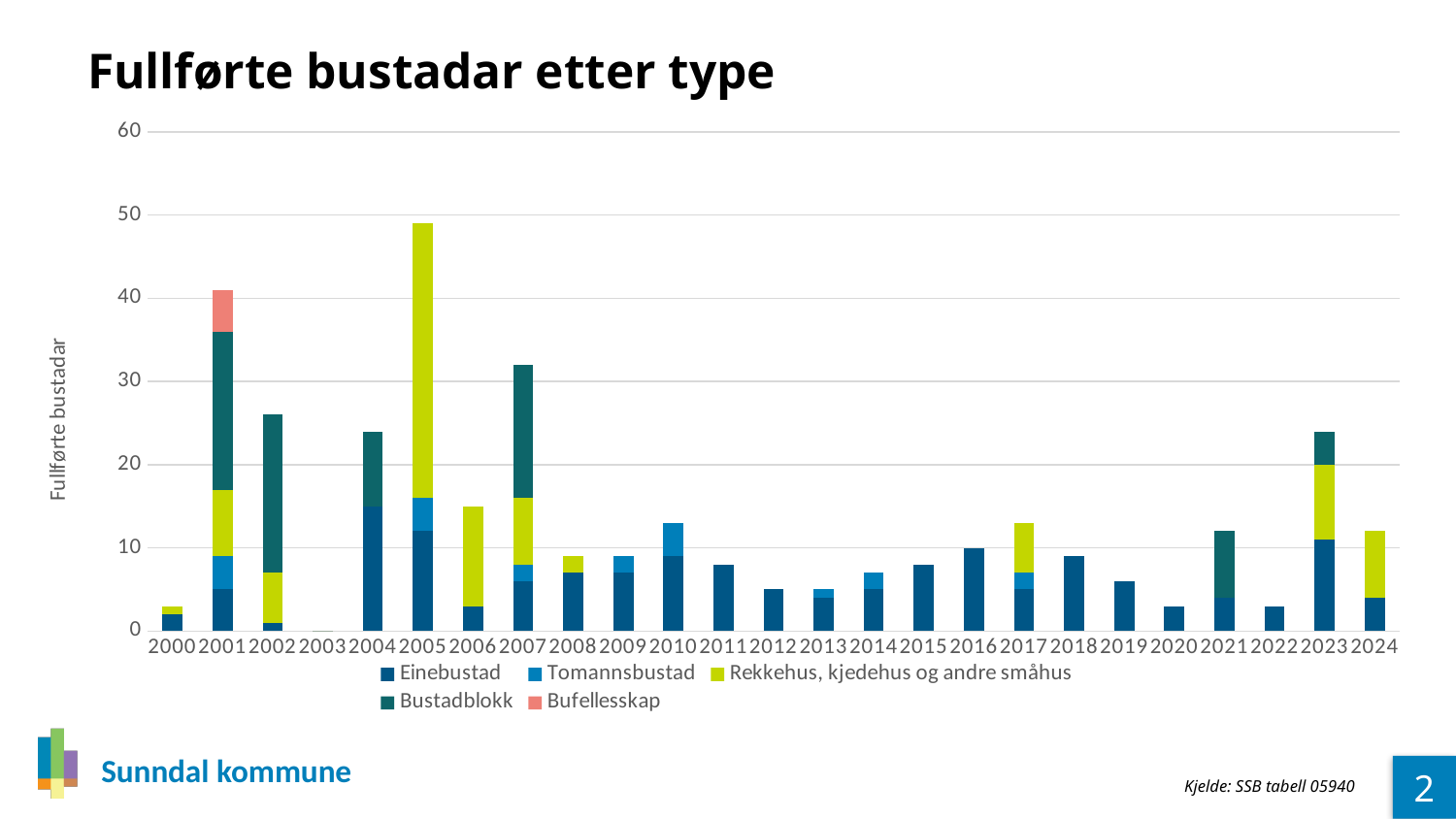
Does the total rise or fall from 2023 to 2024? fall Which year has the larger total, 2001 or 2002? 2001 What is the title of the chart? Fullførte bustadar etter type What kind of chart is shown on the slide? Stacked bar chart Is the total for 2005 greater or less than 40? greater Which year has the lowest total of completed dwellings? 2003 Is the total for 2001 greater or less than 30? greater Which year has the highest total of completed dwellings? 2005 How many years are shown along the x axis? 25 Is the total for 2012 greater or less than 10? less How many series does the legend list? 5